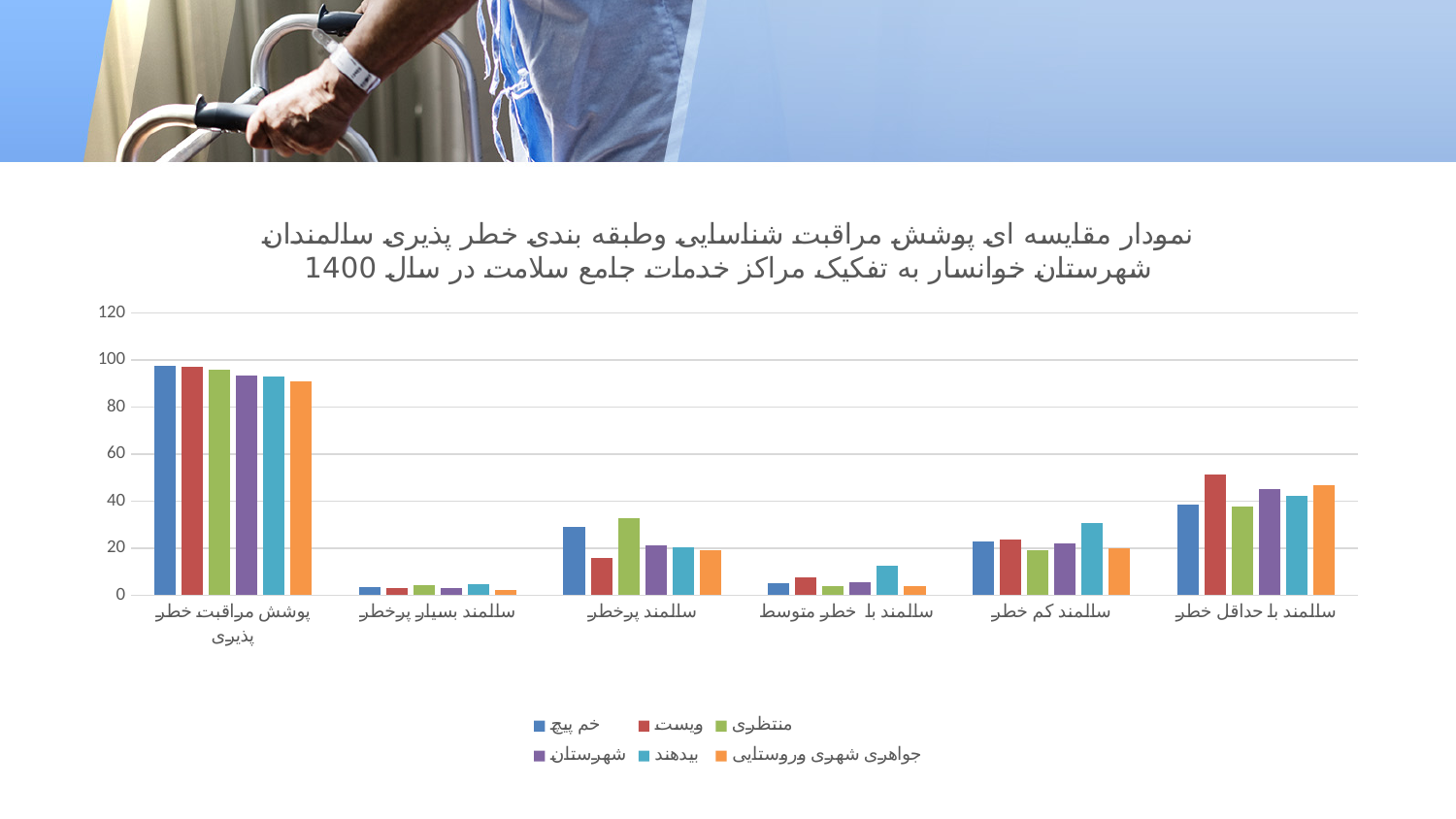
How many series does the chart's legend list? 6 How many categories are shown along the x axis of the chart? 6 In the category سالمند با حداقل خطر, which is larger: the value for ویست or the value for منتظری? ویست Which category has the tallest bars overall in the chart? پوشش مراقبت خطر پذیری Is the value for ویست in the category سالمند با حداقل خطر greater or less than 40? greater Is the value for بیدهند in the category سالمند با خطر متوسط greater or less than 20? less What colour represents the series بیدهند in the chart's legend? teal (light blue) In the category سالمند پرخطر, which series has the highest value? منتظری In the category سالمند کم خطر, which series has the highest value? بیدهند Is the value for منتظری in the category سالمند پرخطر greater or less than 20? greater What kind of chart is shown on the slide? bar chart